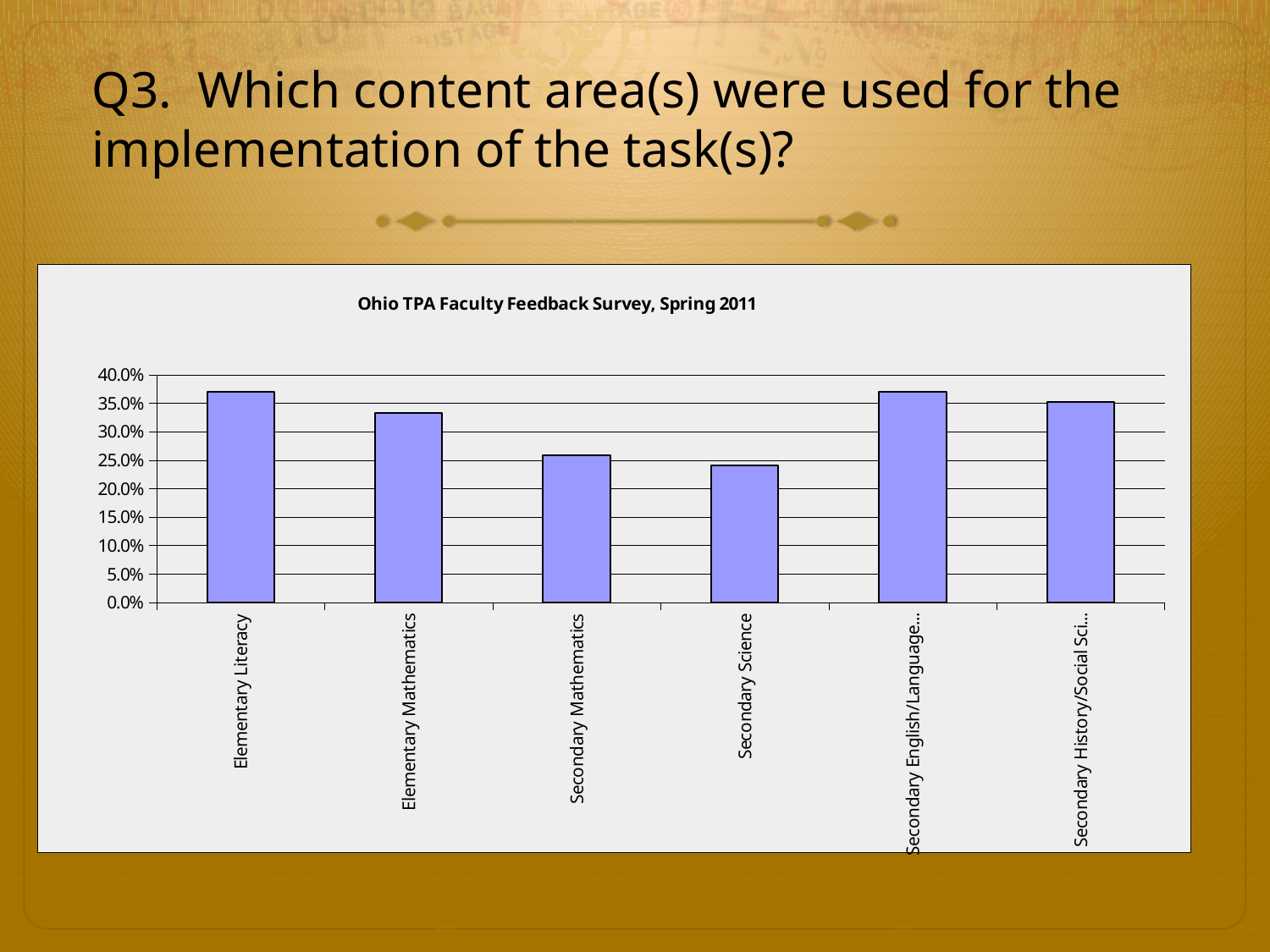
What is the highest value shown on the vertical axis of the chart? 40.0% Which is larger, the value for Elementary Literacy or the value for Secondary Mathematics? Elementary Literacy Is the value for Secondary History/Social Sci... greater or less than 30.0%? greater What kind of chart is shown on the slide? Bar chart Is the value for Secondary Science greater or less than 25.0%? less What is the title of the chart? Ohio TPA Faculty Feedback Survey, Spring 2011 Is the value for Secondary Mathematics greater or less than 30.0%? less Which is larger, the value for Elementary Mathematics or the value for Secondary Science? Elementary Mathematics How many content area categories are plotted on the chart? 6 Which content area has the lowest value on the chart? Secondary Science